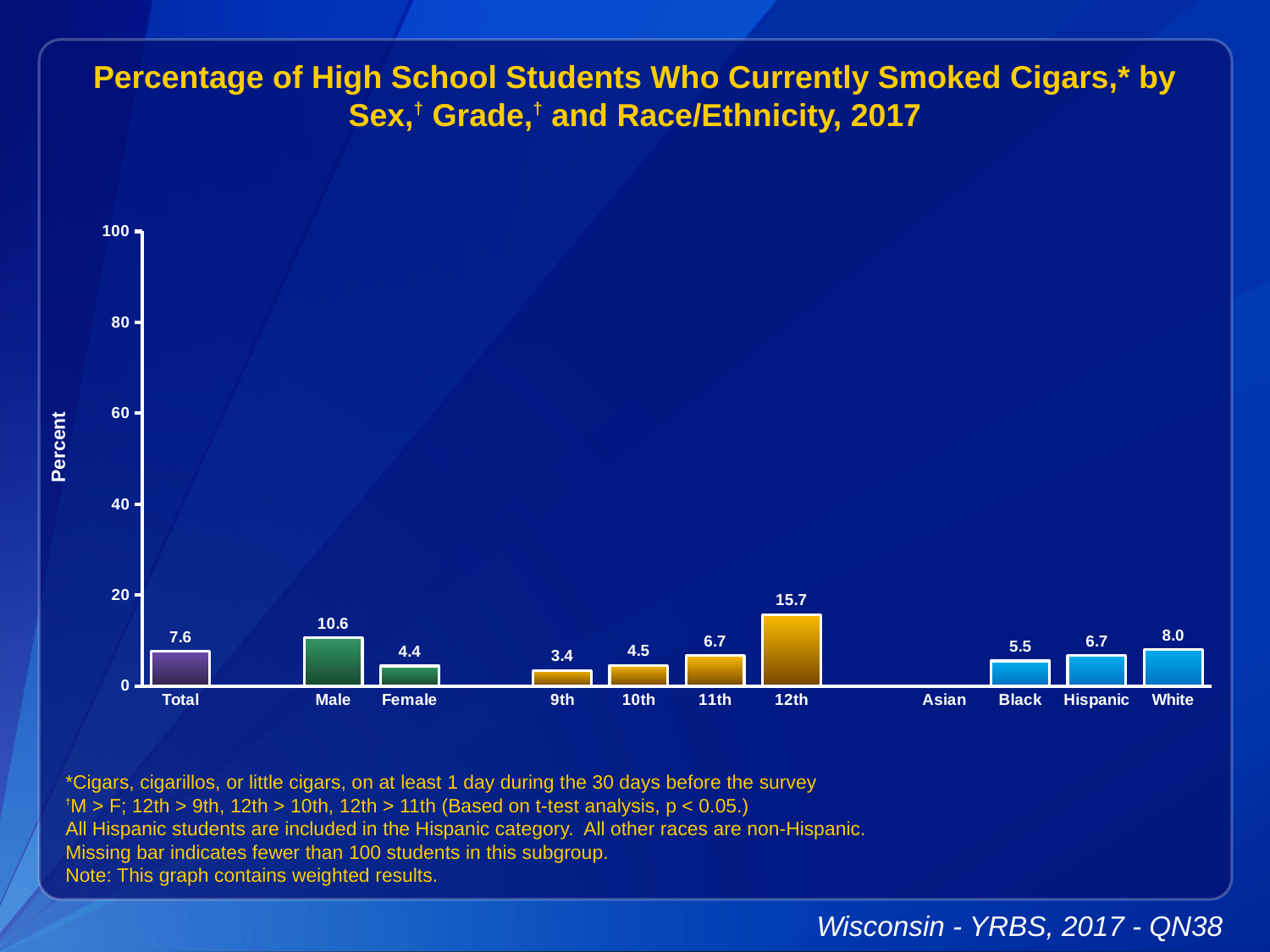
What is the difference between the Male and Female values? 6.2 What is the value for Hispanic? 6.7 Which is larger, the value for White or the value for Black? White What is the value for Male? 10.6 Which category has the highest value? 12th What kind of chart is shown? bar chart How many categories have a bar plotted? 10 Is the value for 12th grade greater or less than 20? less Which category with a bar has the lowest value? 9th Do the values rise or fall from 9th grade to 12th grade? rise What is the value for Total? 7.6 What is the value for 12th grade? 15.7